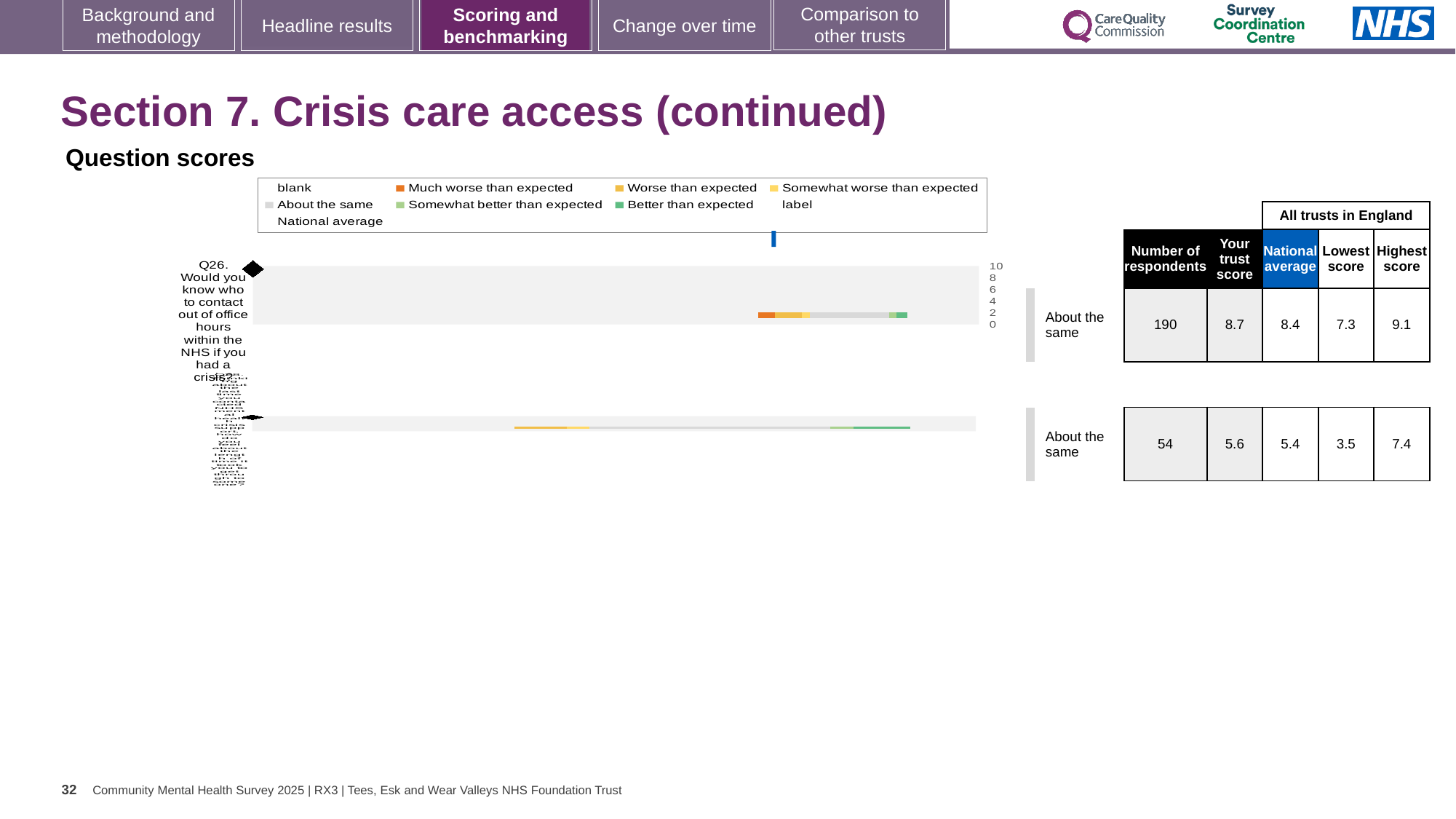
Which colour in the legend represents 'About the same'? Grey What kind of chart is used to show the question scores? Bar chart Which colour in the legend represents 'Much worse than expected'? Orange Which benchmark category is Q26 placed in? About the same What is the lowest score among all trusts in England for Q26? 7.3 What is the difference between the highest and lowest trust scores in England for Q26? 1.8 How many respondents answered Q26? 190 What is the highest score among all trusts in England for Q26? 9.1 What is the trust score for Q26 (Would you know who to contact out of office hours within the NHS if you had a crisis?)? 8.7 For Q26, which is larger: the trust score or the national average? The trust score (8.7) What is the national average score for Q26? 8.4 By how much does the trust score for Q26 exceed the national average? 0.3